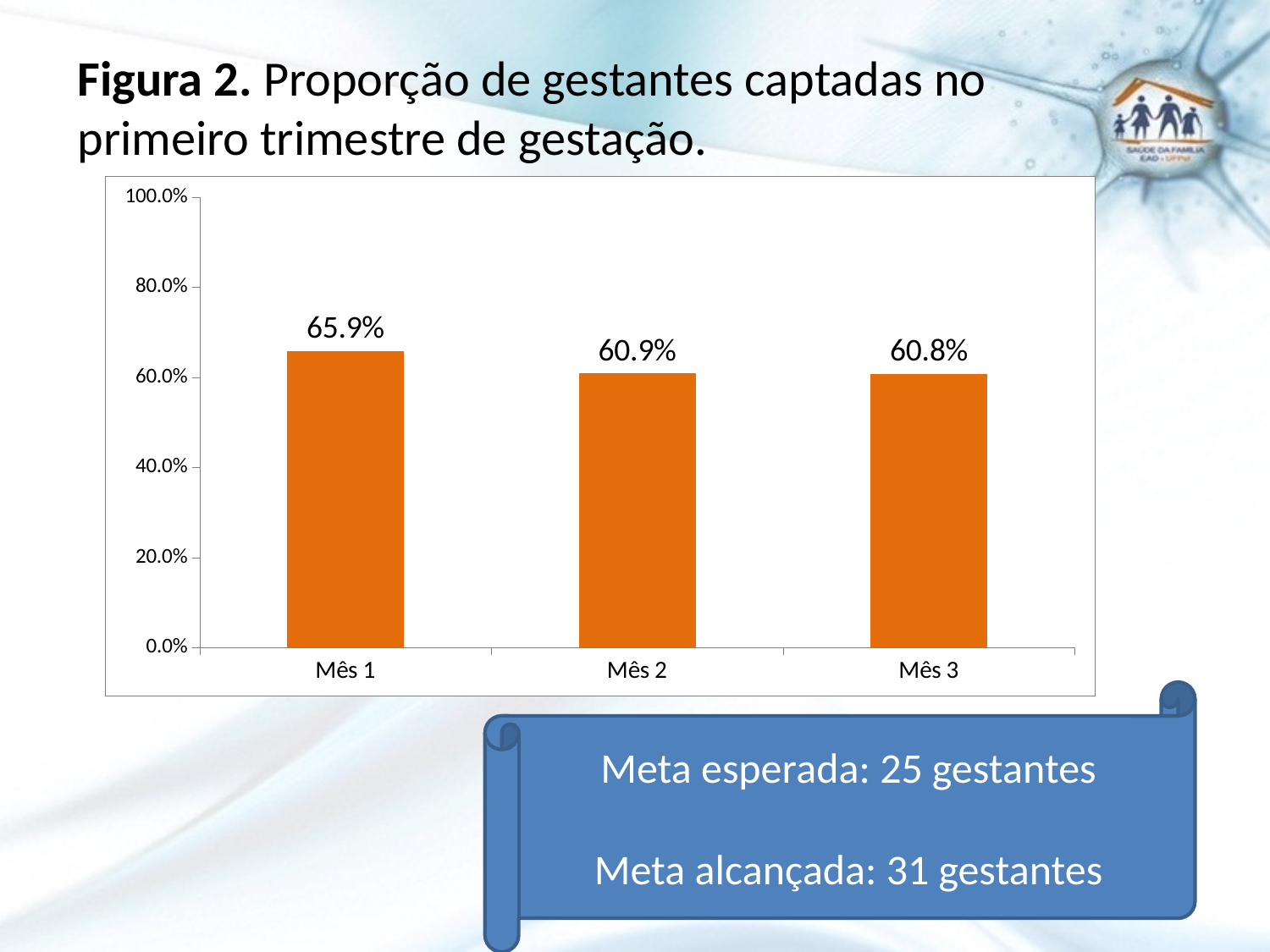
Which month has the highest value? Mês 1 Which is larger, the value for Mês 1 or the value for Mês 3? Mês 1 Do the values rise or fall from Mês 1 to Mês 3? Fall What is the value for Mês 3? 60.8% What is the value for Mês 2? 60.9% What is the value for Mês 1? 65.9% What is the difference between the values for Mês 1 and Mês 3? 5.1 percentage points Is the value for Mês 2 greater or less than 80.0%? less What is the difference between the values for Mês 1 and Mês 2? 5.0 percentage points How many months are shown on the x axis? 3 What colour are the bars in the chart? Orange What kind of chart is shown on the slide? Bar chart